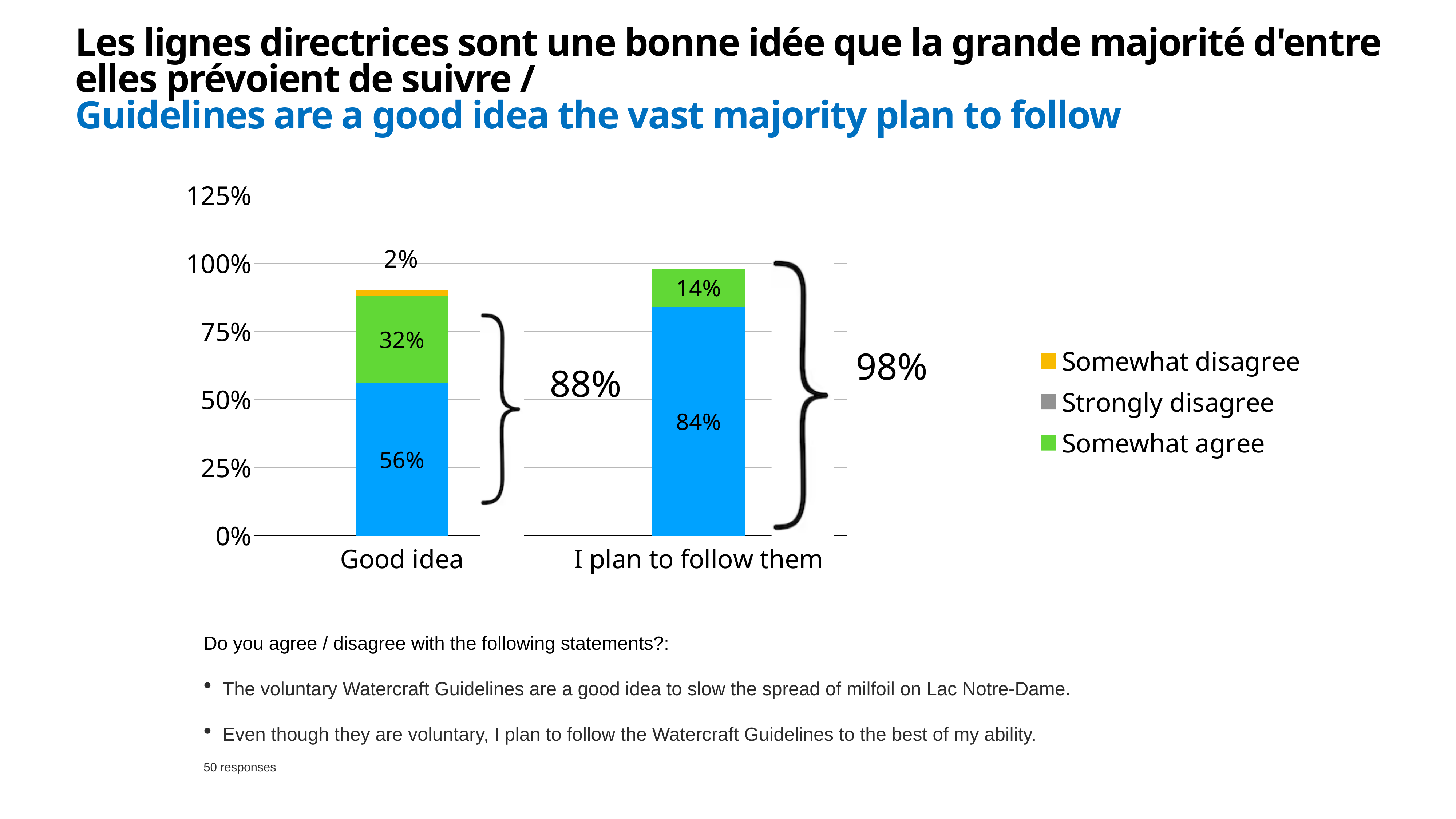
What is the difference between the Somewhat agree values for Good idea and I plan to follow them? 18% What is the value of the blue (bottom) segment for I plan to follow them? 84% What is the value of the Somewhat agree segment for Good idea? 32% What is the total of the stacked bar for I plan to follow them? 98% What is the value of the Somewhat disagree segment for Good idea? 2% What kind of chart is shown on the slide? Stacked bar chart How many series does the legend list? 3 What percentage is shown next to the brace beside the Good idea bar? 88% What is the value of the Somewhat agree segment for I plan to follow them? 14% Which category has the larger blue (bottom) segment, Good idea or I plan to follow them? I plan to follow them What is the value of the blue (bottom) segment for Good idea? 56% How many categories are shown on the x axis? 2